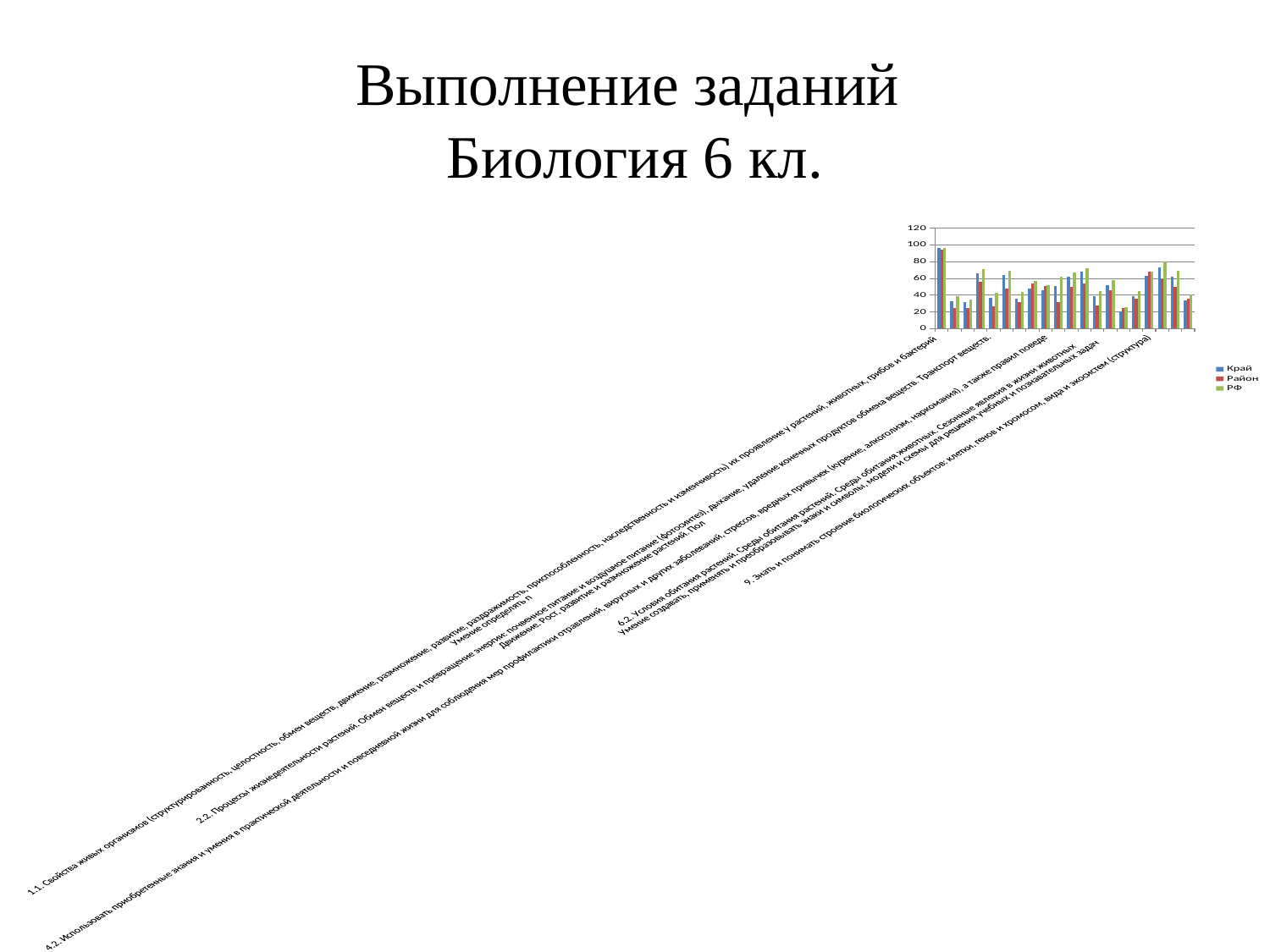
Is the value for Район in the first category (1.1. Свойства живых организмов...) greater or less than 80? greater Is the value for Край in the first category (1.1. Свойства живых организмов...) greater or less than 80? greater Is the value for РФ in the first category (1.1. Свойства живых организмов...) greater or less than 80? greater How many series does the chart legend list? 3 What is the highest value shown on the chart's vertical axis? 120 What kind of chart is shown on the slide? bar chart What are the three series named in the chart legend? Край, Район, РФ